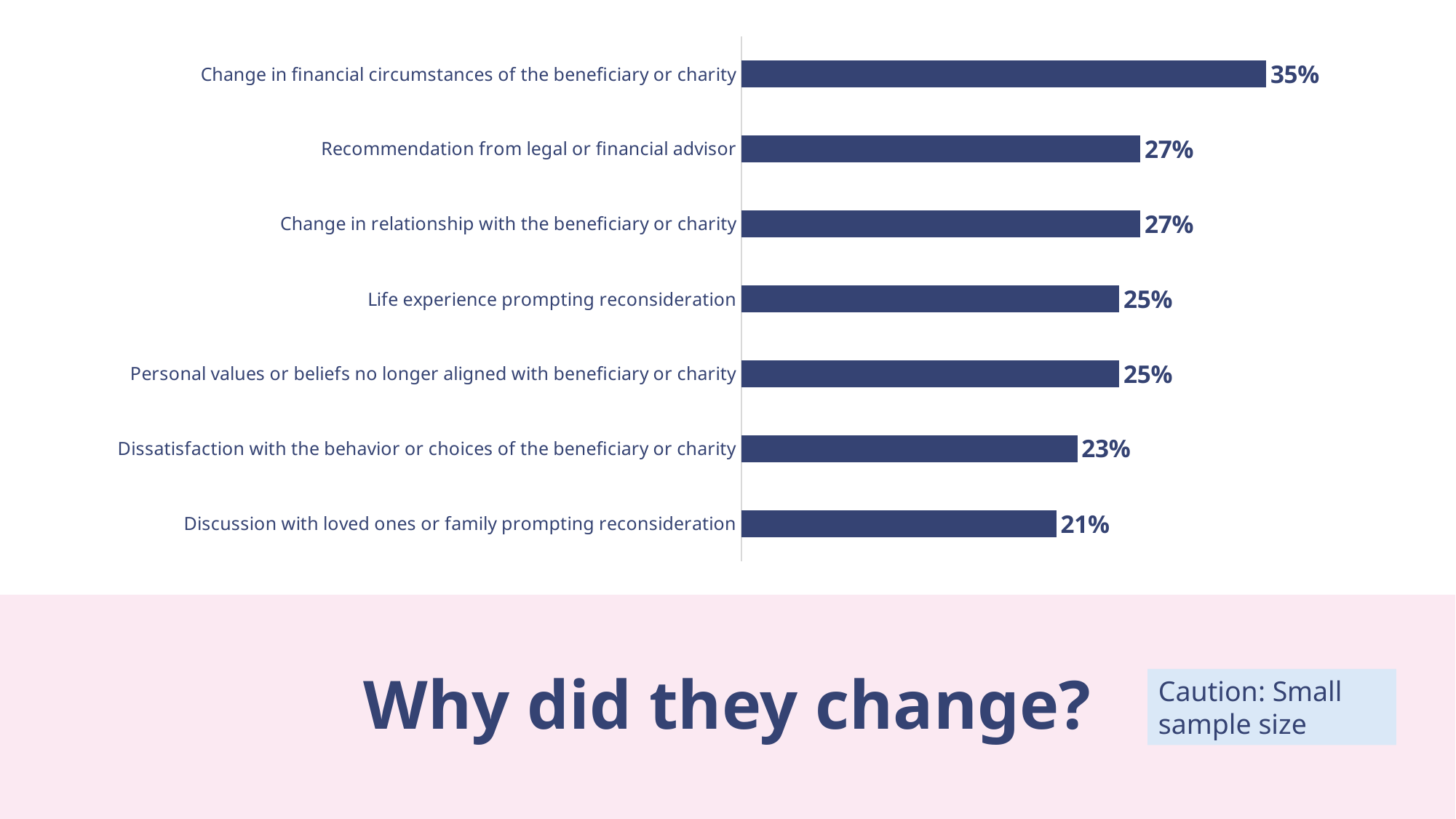
Which reason has the lowest percentage? Discussion with loved ones or family prompting reconsideration What kind of chart is shown on the slide? Bar chart What percentage is shown for "Change in financial circumstances of the beneficiary or charity"? 35% What value is shown for "Recommendation from legal or financial advisor"? 27% What percentage is shown for "Discussion with loved ones or family prompting reconsideration"? 21% Which is larger: the value for "Life experience prompting reconsideration" or the value for "Dissatisfaction with the behavior or choices of the beneficiary or charity"? Life experience prompting reconsideration What is the difference between "Recommendation from legal or financial advisor" and "Life experience prompting reconsideration"? 2 percentage points What is the title text shown below the chart? Why did they change? How many reasons are listed in the chart? 7 Which reason has the highest percentage? Change in financial circumstances of the beneficiary or charity What value is shown for "Dissatisfaction with the behavior or choices of the beneficiary or charity"? 23% What is the difference in percentage points between "Change in financial circumstances of the beneficiary or charity" and "Discussion with loved ones or family prompting reconsideration"? 14 percentage points